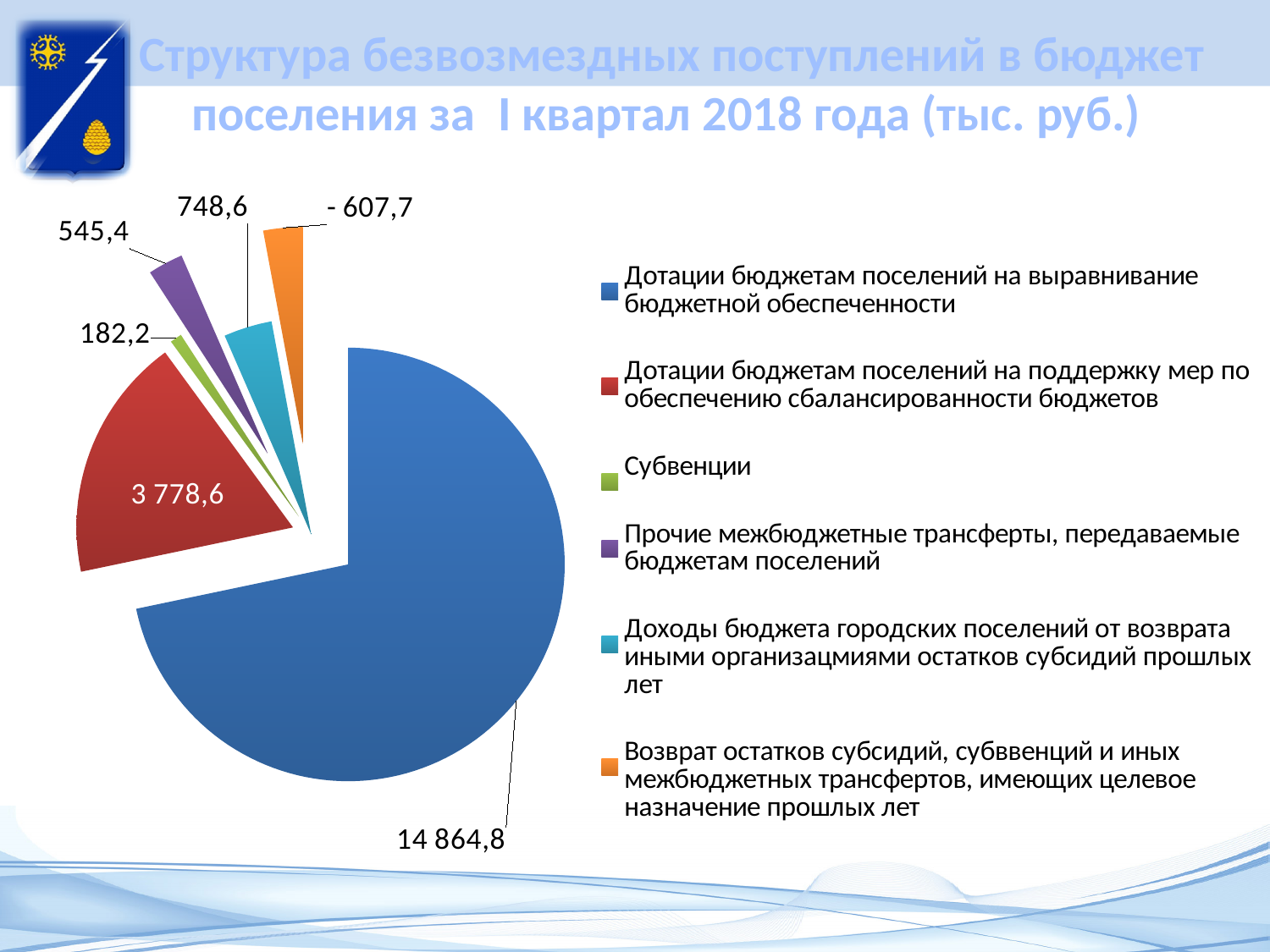
What is the value for "Доходы бюджета городских поселений от возврата иными организацмиями остатков субсидий прошлых лет"? 748,6 Which is larger: the value for "Прочие межбюджетные трансферты, передаваемые бюджетам поселений" or the value for "Субвенции"? Прочие межбюджетные трансферты, передаваемые бюджетам поселений What is the value for "Дотации бюджетам поселений на выравнивание бюджетной обеспеченности"? 14 864,8 What is the value for "Субвенции"? 182,2 What type of chart is shown on the slide? pie chart How many entries does the legend list? 6 What is the value for "Прочие межбюджетные трансферты, передаваемые бюджетам поселений"? 545,4 What is the value for "Дотации бюджетам поселений на поддержку мер по обеспечению сбалансированности бюджетов"? 3 778,6 Which category has the largest slice in the pie chart? Дотации бюджетам поселений на выравнивание бюджетной обеспеченности What is the difference between the value for "Дотации бюджетам поселений на выравнивание бюджетной обеспеченности" and the value for "Дотации бюджетам поселений на поддержку мер по обеспечению сбалансированности бюджетов"? 11 086,2 What value is printed for the orange slice, "Возврат остатков субсидий, суббвенций и иных межбюджетных трансфертов, имеющих целевое назначение прошлых лет"? - 607,7 How many slices does the pie chart have? 6